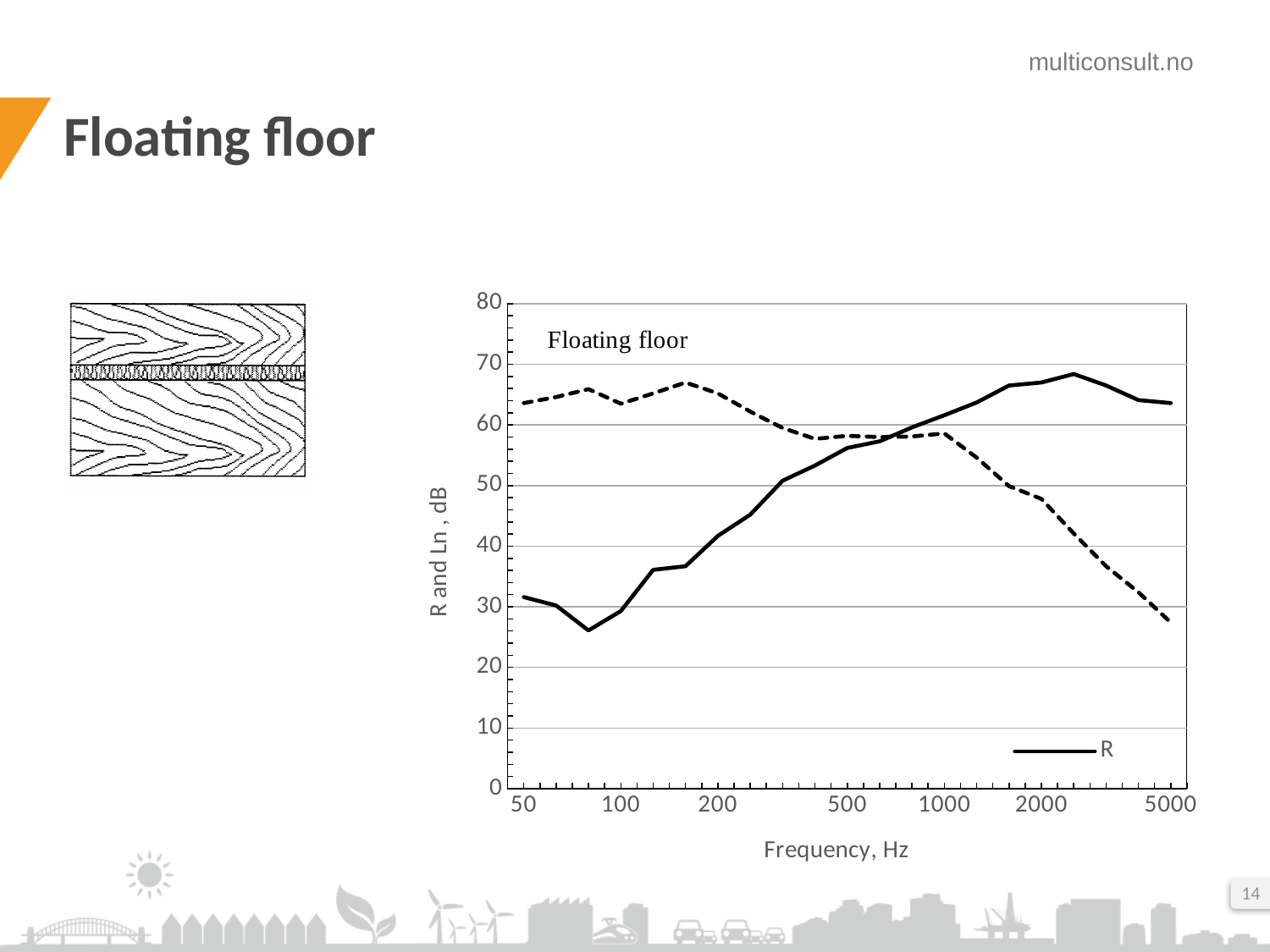
At 5000 Hz, which line has the higher value, the solid R line or the dashed line? the solid R line At 50 Hz, which line has the higher value, the solid R line or the dashed line? the dashed line What kind of chart is shown on the slide? line chart Is the value of the solid R line at 5000 Hz greater or less than 60? greater How many series does the chart's legend list? 1 Is the value of the solid R line at 2000 Hz greater or less than 60? greater Is the value of the dashed line at 5000 Hz greater or less than 30? less What is the label of the x axis of the chart? Frequency, Hz What is the title shown inside the chart's plot area? Floating floor Does the dashed line rise or fall between 1000 Hz and 5000 Hz? fall